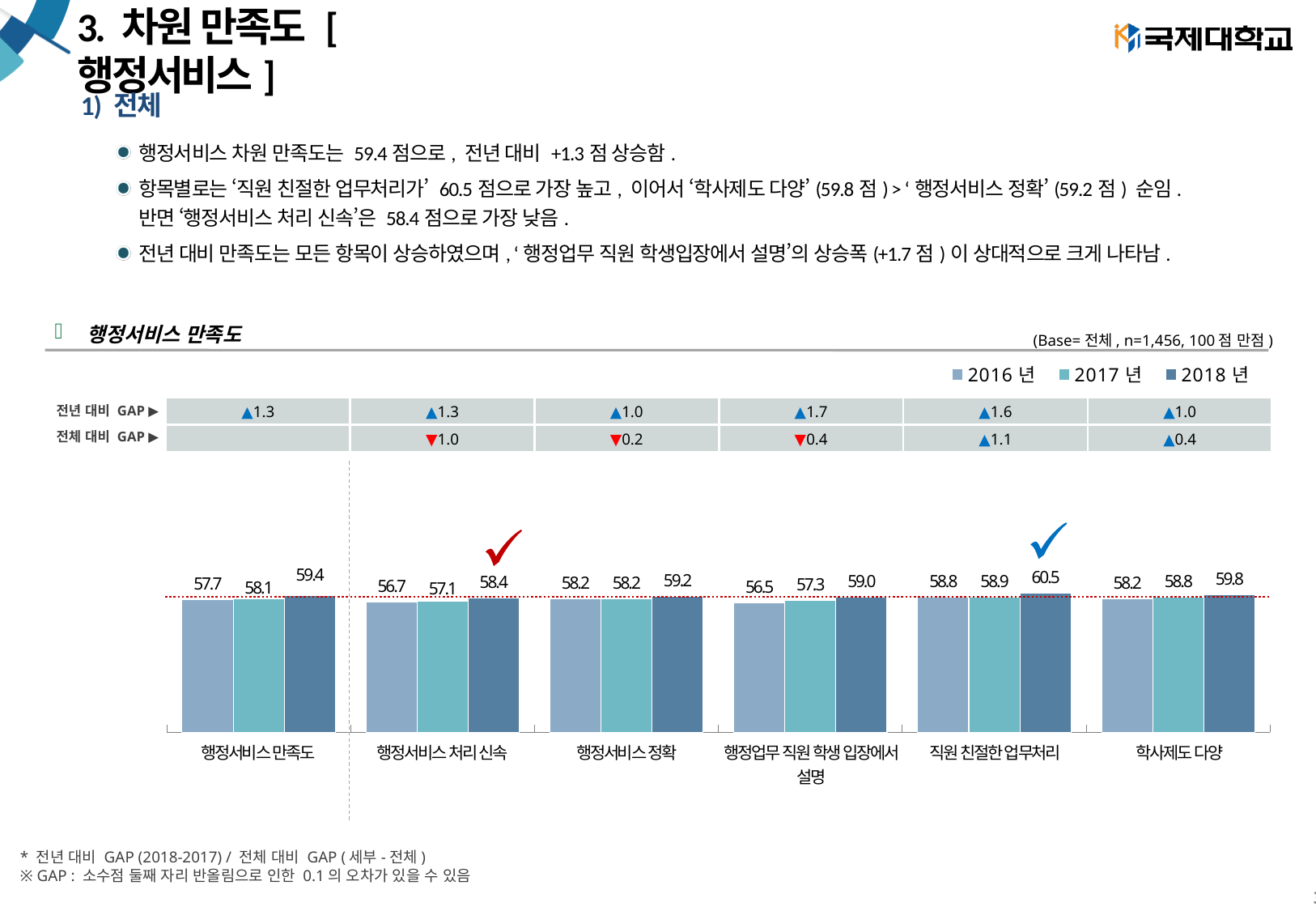
What is the title of the chart? 행정서비스 만족도 What is the 2018년 value for 행정서비스 만족도? 59.4 What kind of chart is shown on the slide? bar chart What is the difference between the 2018년 and 2017년 values for 행정업무 직원 학생 입장에서 설명? 1.7 Which is larger, the 2018년 value for 행정서비스 정확 or the 2018년 value for 학사제도 다양? 학사제도 다양 How many series does the legend list? 3 What is the 2017년 value for 학사제도 다양? 58.8 For 행정서비스 처리 신속, do the values rise or fall from 2016년 to 2018년? rise Which category has the lowest 2016년 value? 행정업무 직원 학생 입장에서 설명 Which category has the highest 2018년 value? 직원 친절한 업무처리 How many categories are shown on the x axis of the chart? 6 What is the 2016년 value for 행정업무 직원 학생 입장에서 설명? 56.5